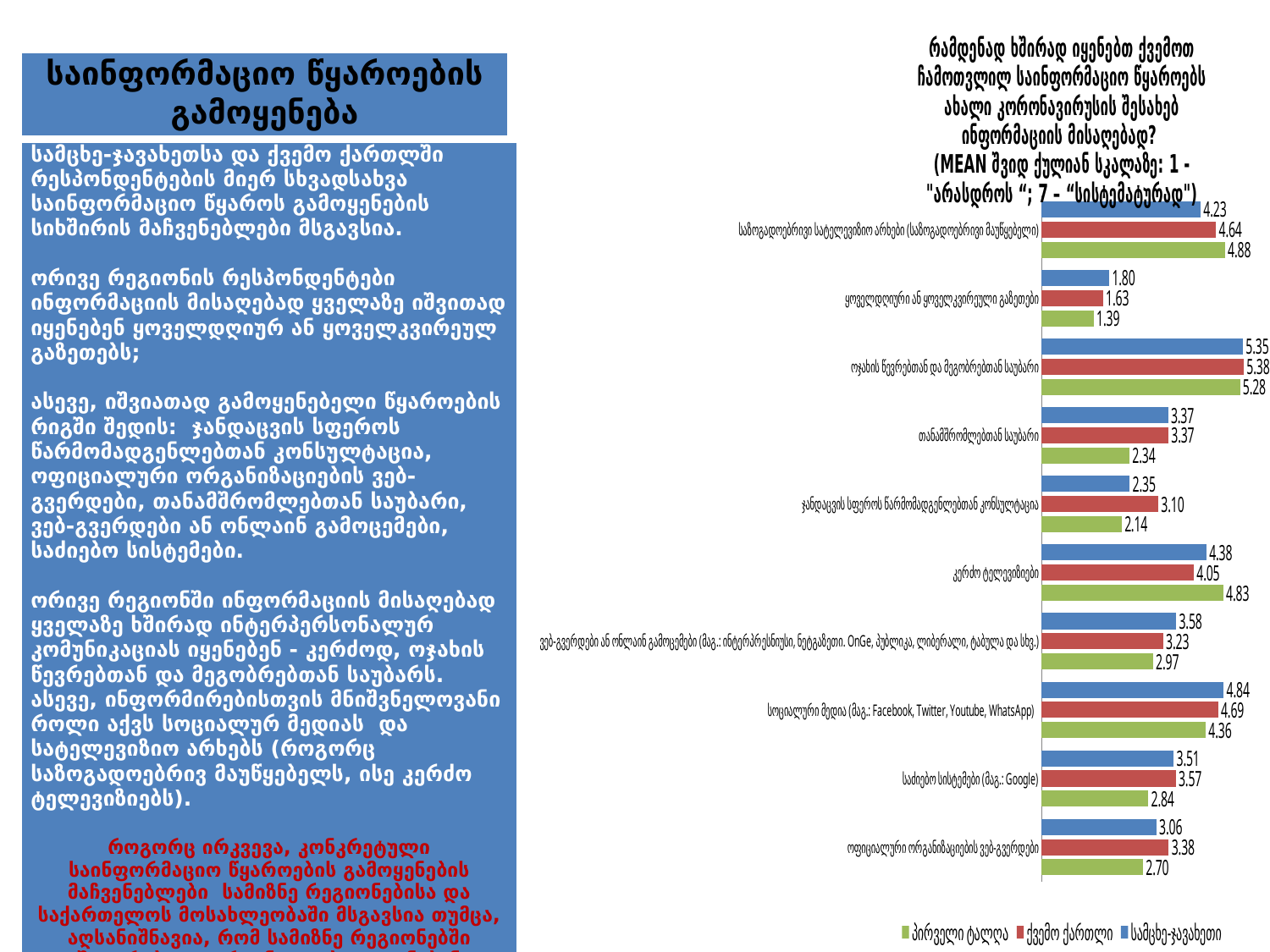
Which category has the highest value for სამცხე-ჯავახეთი? ოჯახის წევრებთან და მეგობრებთან საუბარი How many series does the legend list? 3 What is the value for სამცხე-ჯავახეთი for სოციალური მედია (Facebook, Twitter, Youtube, WhatsApp)? 4.84 What is the difference between the სამცხე-ჯავახეთი and პირველი ტალღა values for საზოგადოებრივი სატელევიზიო არხები? 0.65 For კერძო ტელევიზიები, which series has the larger value: პირველი ტალღა or ქვემო ქართლი? პირველი ტალღა How many information-source categories are plotted in the chart? 10 What is the value for პირველი ტალღა for საძიებო სისტემები (Google)? 2.84 What is the value for ქვემო ქართლი for ოჯახის წევრებთან და მეგობრებთან საუბარი? 5.38 Which category has the lowest value for პირველი ტალღა? ყოველდღიური ან ყოველკვირეული გაზეთები What type of chart is shown on the slide? bar chart What is the difference between the ქვემო ქართლი and პირველი ტალღა values for თანამშრომლებთან საუბარი? 1.03 Which colour represents ქვემო ქართლი in the legend? red